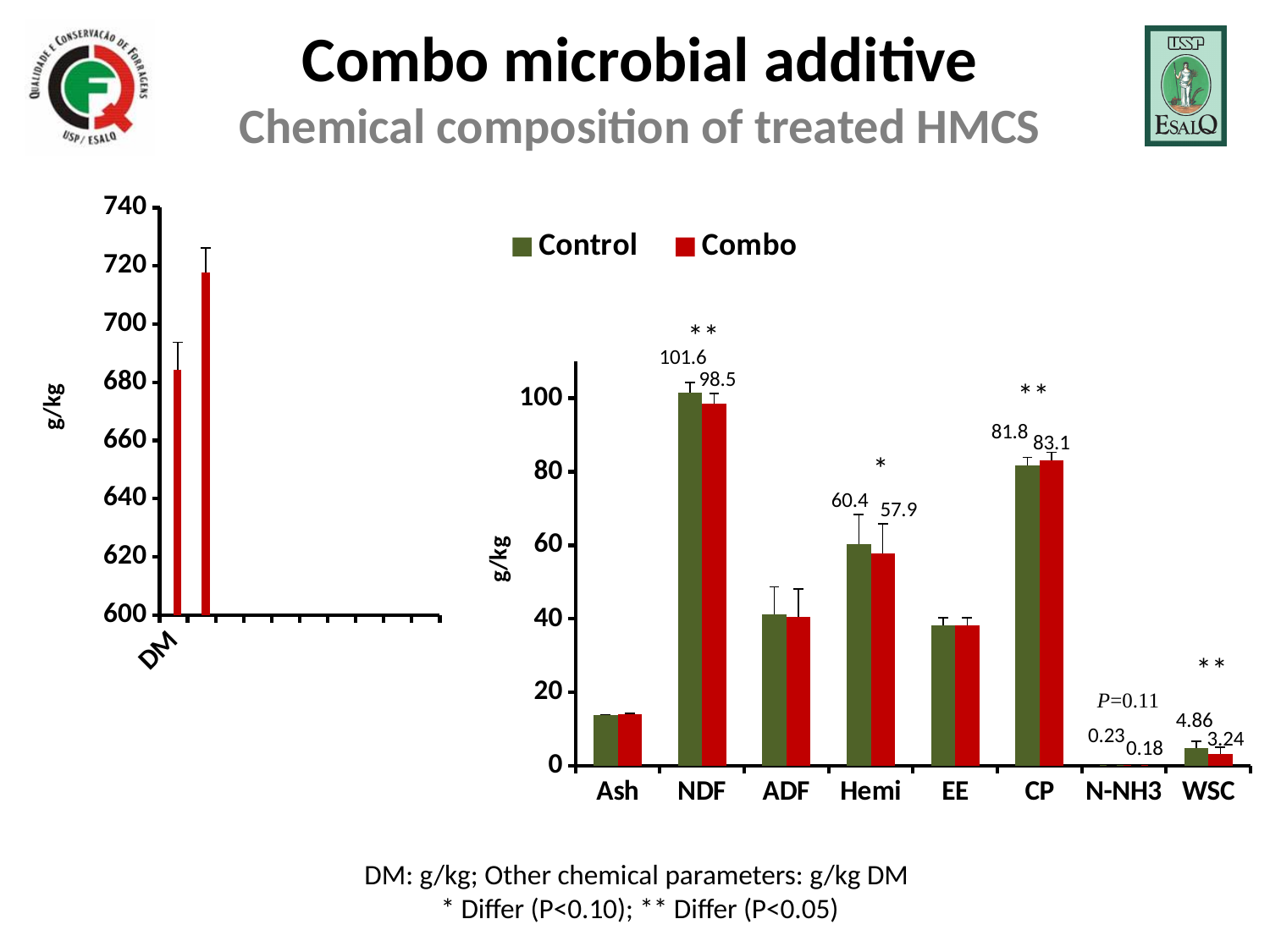
In the right chart, which is larger for CP, the Control value or the Combo value? Combo In the right chart, what is the Combo value for WSC? 3.24 In the right chart, what is the difference between the Control and Combo values for NDF? 3.1 In the right chart, what is the Control value for Hemi? 60.4 What kind of chart is the right chart? bar chart In the right chart, which category has the highest Control value? NDF In the right chart, how many categories are shown on the x axis? 8 In the right chart, what is the Combo value for CP? 83.1 In the right chart, what is the Control value for NDF? 101.6 In the right chart, what is the difference between the Control and Combo values for WSC? 1.62 How many series does the legend list? 2